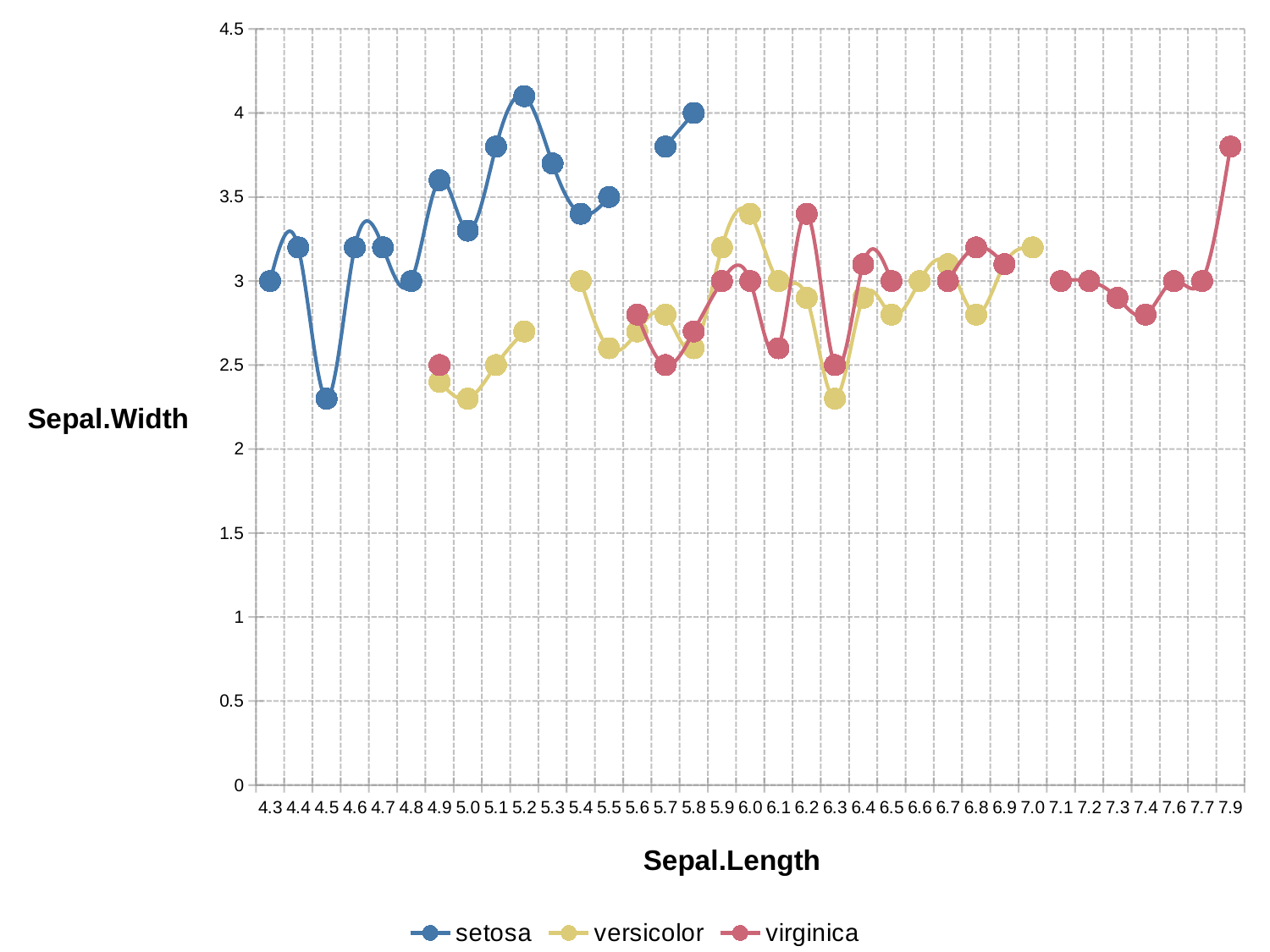
Is the virginica value at Sepal.Length 7.9 greater or less than 3.5? greater Is the setosa value at Sepal.Length 4.5 greater or less than 2.5? less What is the Sepal.Width value for versicolor at Sepal.Length 5.4? 3 What kind of chart is shown on the slide? line chart Which is larger: the setosa value at Sepal.Length 5.2 or the virginica value at Sepal.Length 7.9? setosa at 5.2 What is the Sepal.Width value for virginica at Sepal.Length 4.9? 2.5 What is the Sepal.Width value for setosa at Sepal.Length 5.8? 4 At which Sepal.Length does the virginica series reach its highest Sepal.Width? 7.9 How many series does the legend list? 3 Is the versicolor value at Sepal.Length 6.3 greater or less than 2.5? less What is the Sepal.Width value for setosa at Sepal.Length 4.3? 3 What is the title of the vertical axis? Sepal.Width